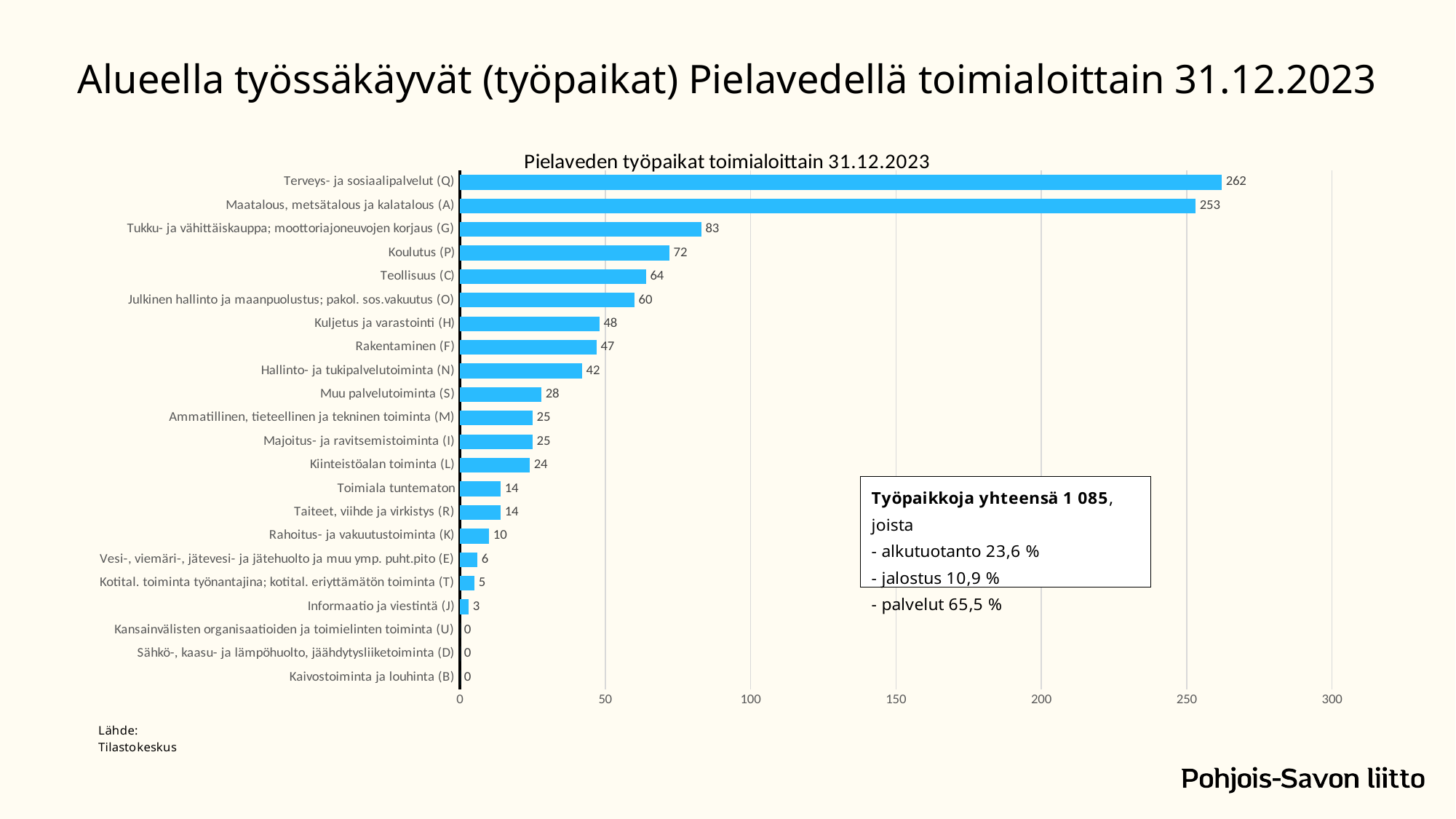
Is the value for Maatalous, metsätalous ja kalatalous (A) greater or less than 200? greater What is the difference between Terveys- ja sosiaalipalvelut (Q) and Maatalous, metsätalous ja kalatalous (A)? 9 What is the value for Terveys- ja sosiaalipalvelut (Q)? 262 Which is larger, Kuljetus ja varastointi (H) or Hallinto- ja tukipalvelutoiminta (N)? Kuljetus ja varastointi (H) Which category has the highest value? Terveys- ja sosiaalipalvelut (Q) What is the value for Koulutus (P)? 72 How many categories have a value of 0? 3 What is the difference between Tukku- ja vähittäiskauppa; moottoriajoneuvojen korjaus (G) and Teollisuus (C)? 19 How many categories are shown in the chart? 22 What is the title of the chart? Pielaveden työpaikat toimialoittain 31.12.2023 What is the value for Rahoitus- ja vakuutustoiminta (K)? 10 What kind of chart is shown on the slide? bar chart